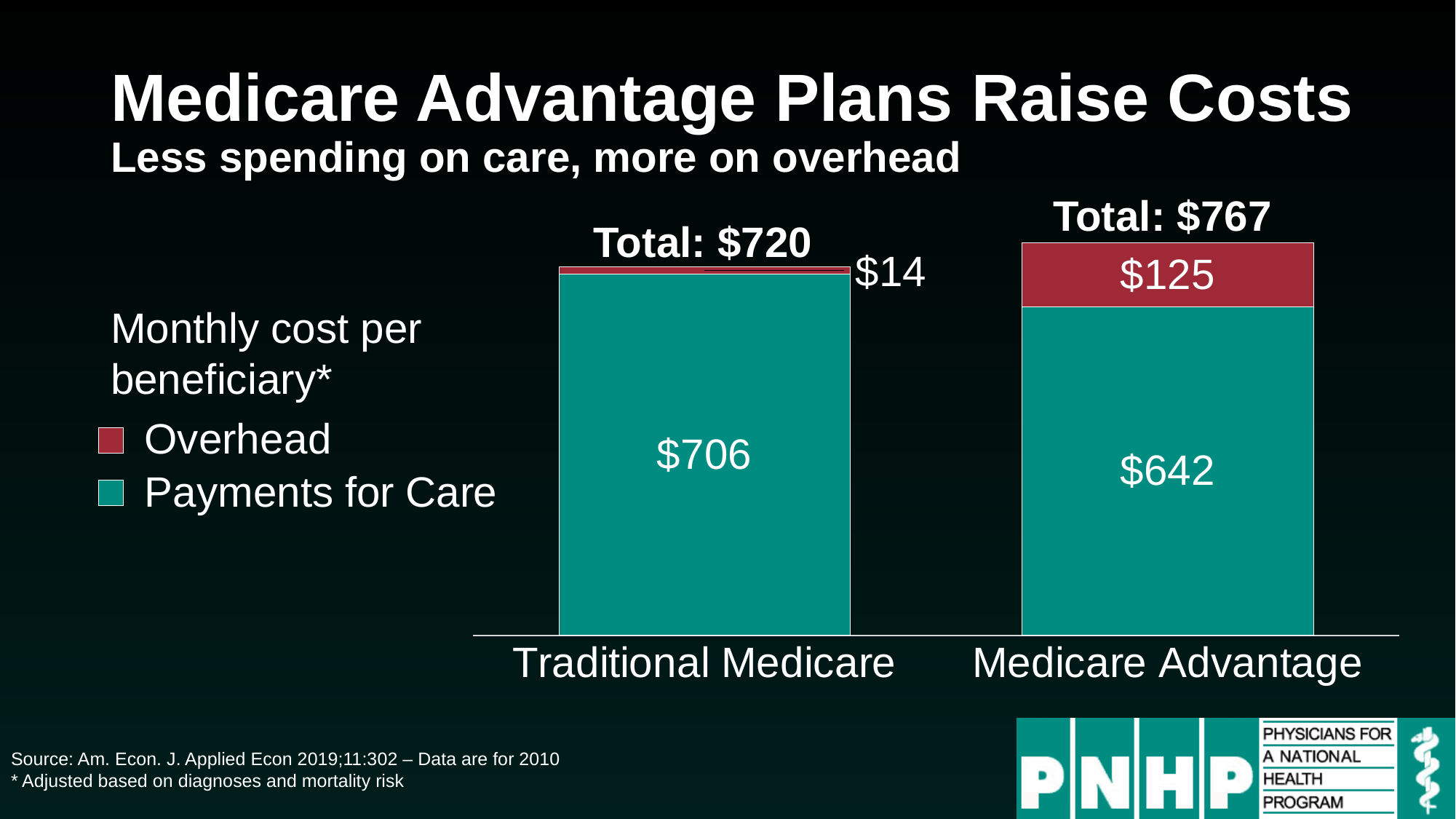
What is the Overhead value for Traditional Medicare? $14 What is the total monthly cost per beneficiary for Medicare Advantage? $767 Which plan has the lower Payments for Care value? Medicare Advantage What is the Payments for Care value for Medicare Advantage? $642 What is the Overhead value for Medicare Advantage? $125 What is the total monthly cost per beneficiary for Traditional Medicare? $720 Which plan has the higher Overhead value? Medicare Advantage What is the difference in Overhead between Medicare Advantage and Traditional Medicare? $111 What kind of chart is shown on the slide? Stacked bar chart What is the Payments for Care value for Traditional Medicare? $706 How many series does the legend list? 2 What is the difference in Payments for Care between Traditional Medicare and Medicare Advantage? $64